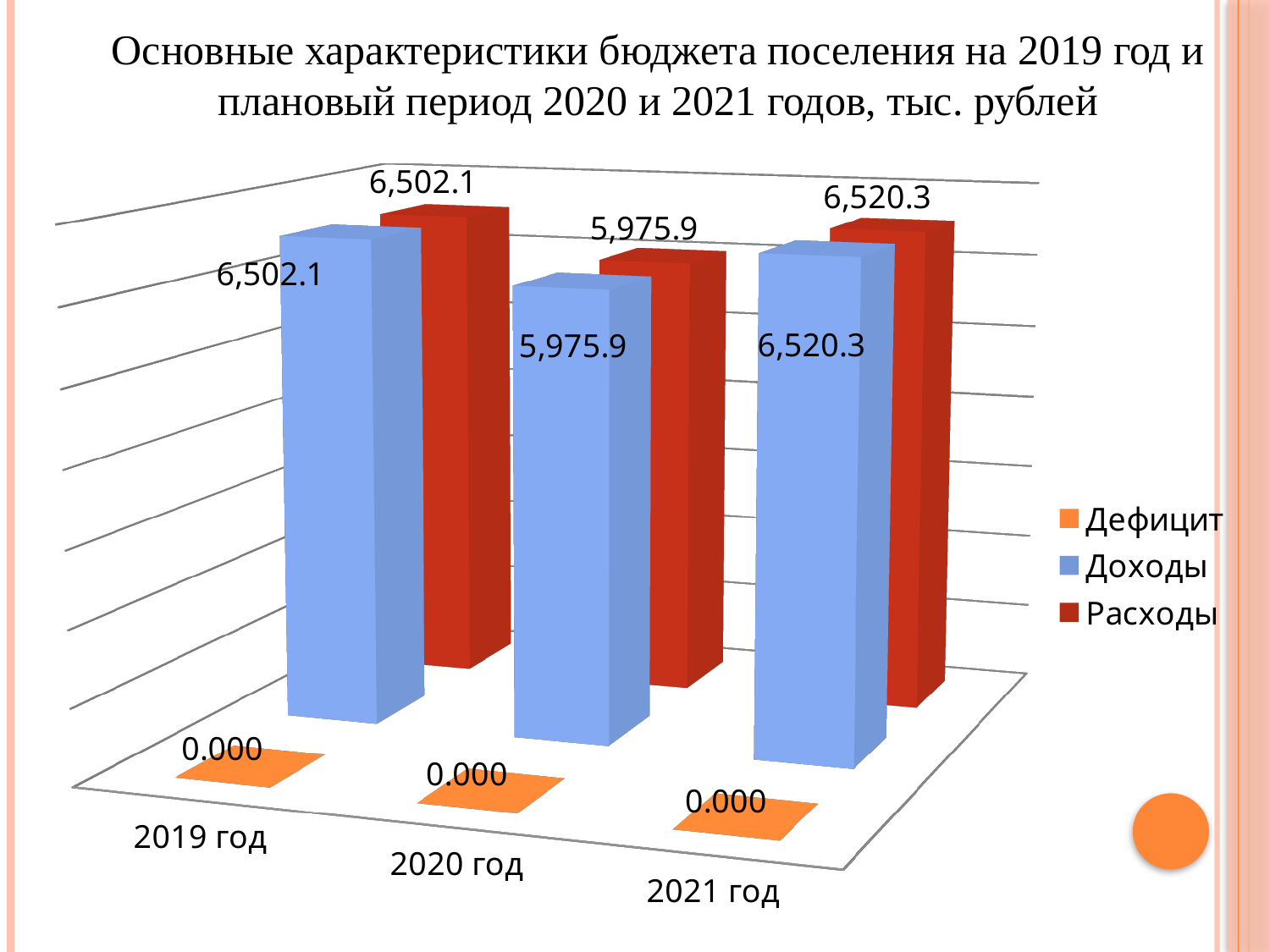
What is the difference between Доходы in 2021 год and Доходы in 2020 год? 544.4 What is the value of Дефицит for 2020 год? 0.000 Which is larger: Расходы in 2019 год or Расходы in 2020 год? Расходы in 2019 год In which year is Расходы the lowest? 2020 год What is the value of Доходы for 2021 год? 6,520.3 In which year is Доходы the highest? 2021 год How many years are shown on the x axis? 3 What is the value of Расходы for 2020 год? 5,975.9 What is the value of Доходы for 2019 год? 6,502.1 How many series does the legend list? 3 Which colour represents Расходы in the legend? Red What kind of chart is shown on the slide? Bar chart